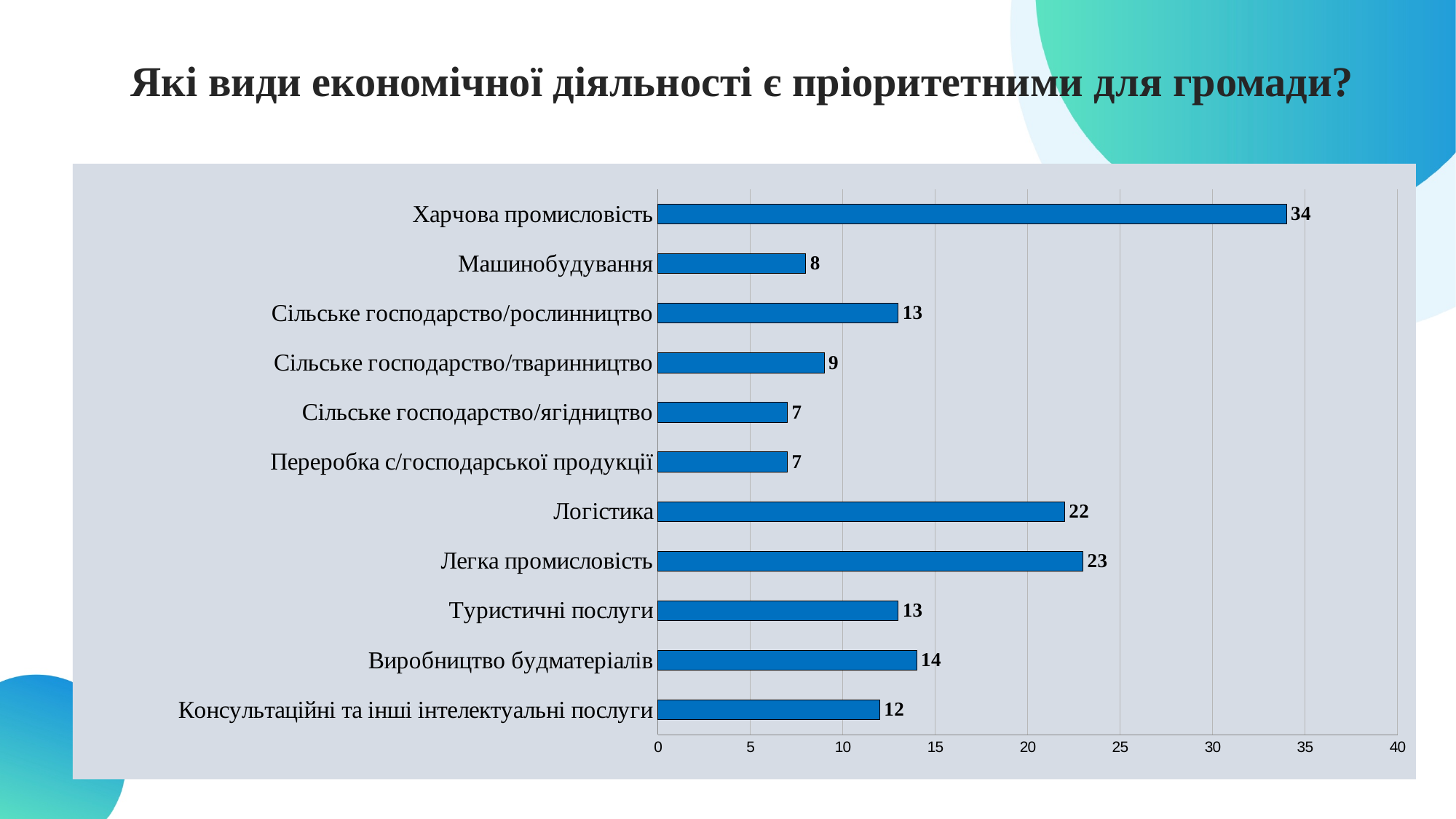
What is the difference between the values for Харчова промисловість and Машинобудування? 26 What is the title of the slide? Які види економічної діяльності є пріоритетними для громади? How many categories are shown in the chart? 11 What is the value for Консультаційні та інші інтелектуальні послуги? 12 What kind of chart is shown on the slide? bar chart What is the value for Логістика? 22 Which category has the highest value? Харчова промисловість What is the value for Сільське господарство/тваринництво? 9 Which is larger, the value for Виробництво будматеріалів or the value for Туристичні послуги? Виробництво будматеріалів What is the difference between the values for Легка промисловість and Логістика? 1 What is the value for Харчова промисловість? 34 Is the value for Сільське господарство/рослинництво greater or less than 10? greater